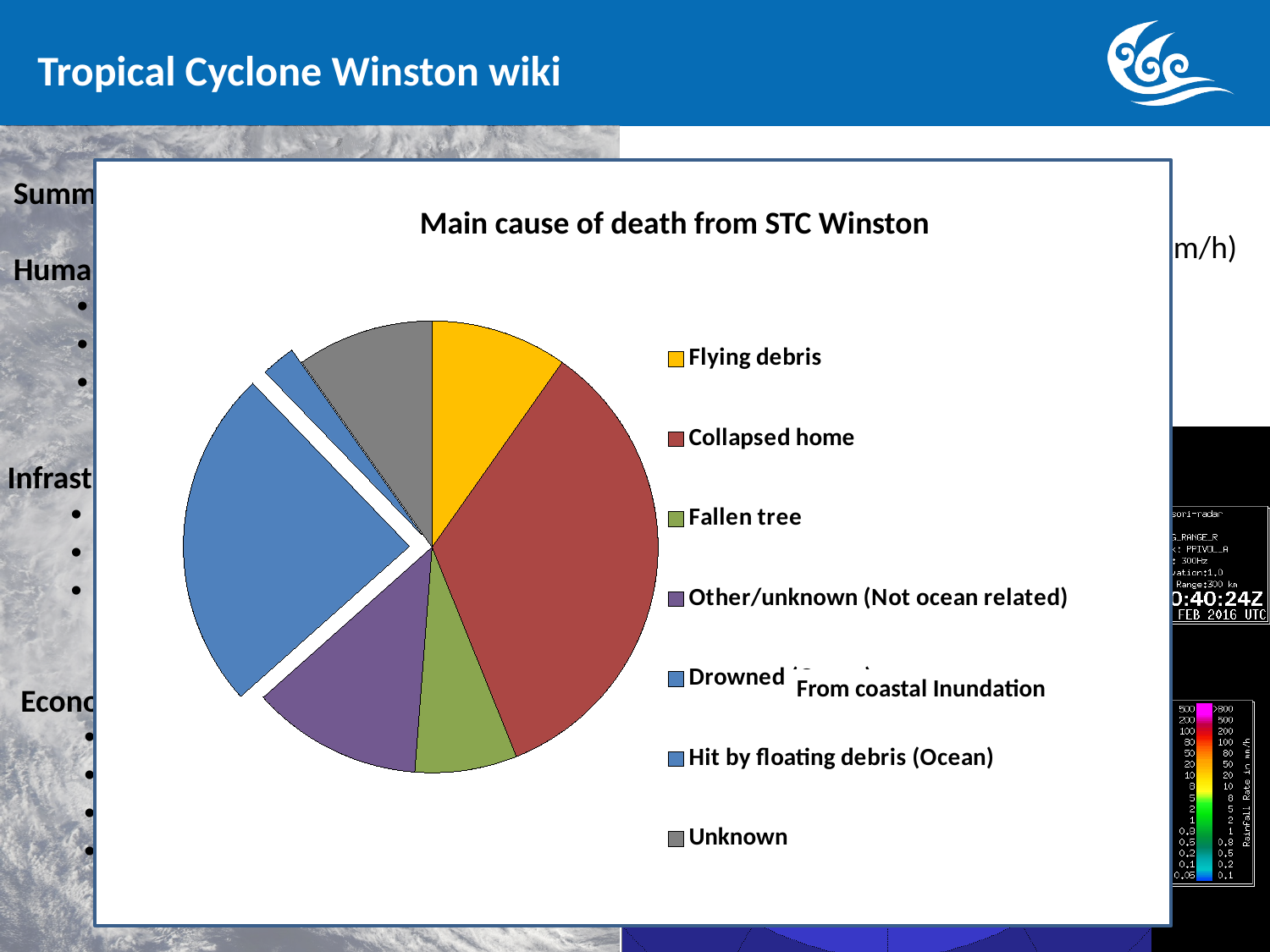
What kind of chart is shown on the slide? Pie chart Which slice is larger: Drowned or Fallen tree? Drowned Which cause of death has the smallest slice of the pie? Hit by floating debris (Ocean) What colour is the Flying debris slice? Yellow Which slice is larger: Other/unknown (Not ocean related) or Hit by floating debris (Ocean)? Other/unknown (Not ocean related) What is the title of the chart? Main cause of death from STC Winston Which slice is larger: Collapsed home or Flying debris? Collapsed home How many categories (slices) does the pie chart have? 7 Which cause of death has the largest slice of the pie? Collapsed home